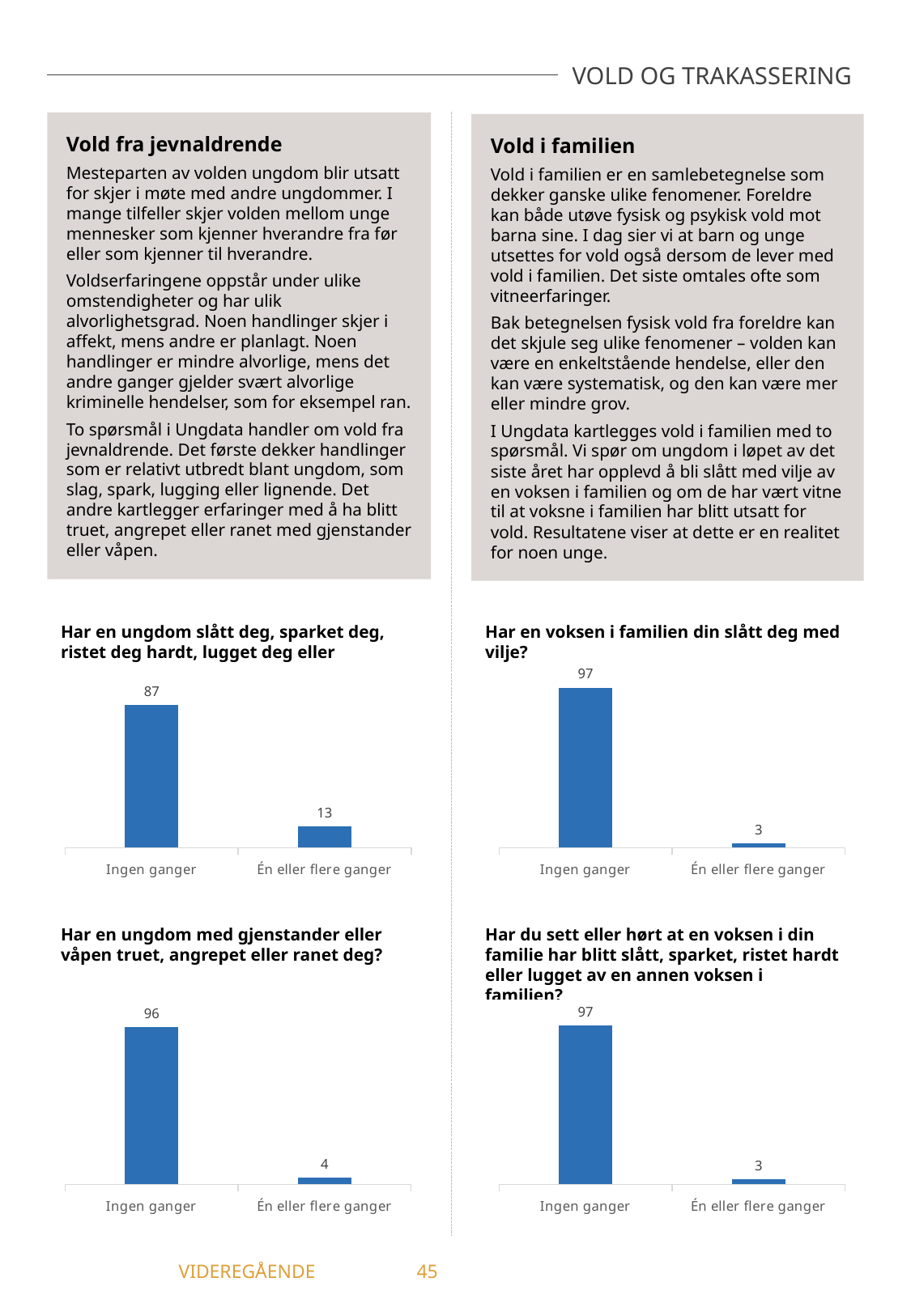
What type of chart is the top-left chart ("Har en ungdom slått deg, sparket deg...")? Bar chart In the top-right chart ("Har en voksen i familien din slått deg med vilje?"), what is the value for "Én eller flere ganger"? 3 How many categories are shown in the bottom-right chart ("Har du sett eller hørt at en voksen i din familie har blitt slått...")? 2 In the top-left chart ("Har en ungdom slått deg, sparket deg..."), what is the difference between "Ingen ganger" and "Én eller flere ganger"? 74 In the top-right chart ("Har en voksen i familien din slått deg med vilje?"), what is the value for "Ingen ganger"? 97 In the top-right chart ("Har en voksen i familien din slått deg med vilje?"), which category has the lowest value? Én eller flere ganger In the top-left chart ("Har en ungdom slått deg, sparket deg, ristet deg hardt, lugget deg eller"), what is the value for "Ingen ganger"? 87 In the top-left chart ("Har en ungdom slått deg, sparket deg..."), what is the value for "Én eller flere ganger"? 13 In the bottom-left chart ("Har en ungdom med gjenstander eller våpen truet..."), which category has the highest value? Ingen ganger In the bottom-left chart ("Har en ungdom med gjenstander eller våpen truet, angrepet eller ranet deg?"), what is the value for "Én eller flere ganger"? 4 In the bottom-right chart ("Har du sett eller hørt at en voksen i din familie har blitt slått..."), what is the value for "Ingen ganger"? 97 In the bottom-left chart ("Har en ungdom med gjenstander eller våpen truet, angrepet eller ranet deg?"), what is the value for "Ingen ganger"? 96